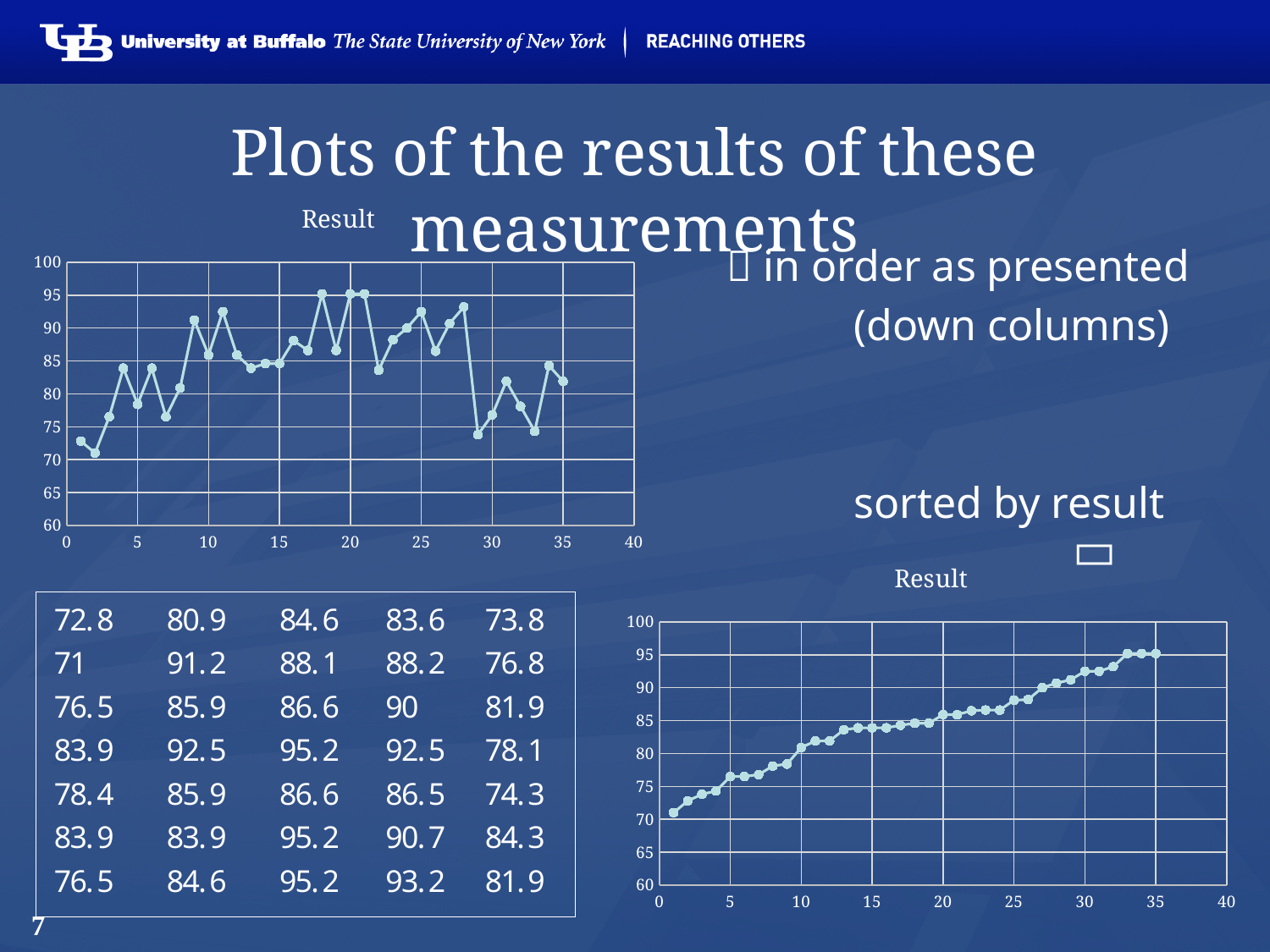
In the bottom-right chart (sorted by result), is the value at x = 1 greater or less than 75? less What type of chart is the top-left chart titled "Result"? line chart In the top-left chart (in order as presented), is the value at x = 2 greater or less than 75? less In the bottom-right chart (sorted by result), is the value at x = 25 greater or less than 85? greater What is the lowest value shown on the y axis of the top-left chart? 60 In the bottom-right chart (sorted by result), at which x value is the highest point? 33, 34 and 35 (tied) In the bottom-right chart (sorted by result), do the values rise or fall as x increases? rise What type of chart is the bottom-right chart titled "Result"? line chart In the bottom-right chart (sorted by result), at which x value is the lowest point? 1